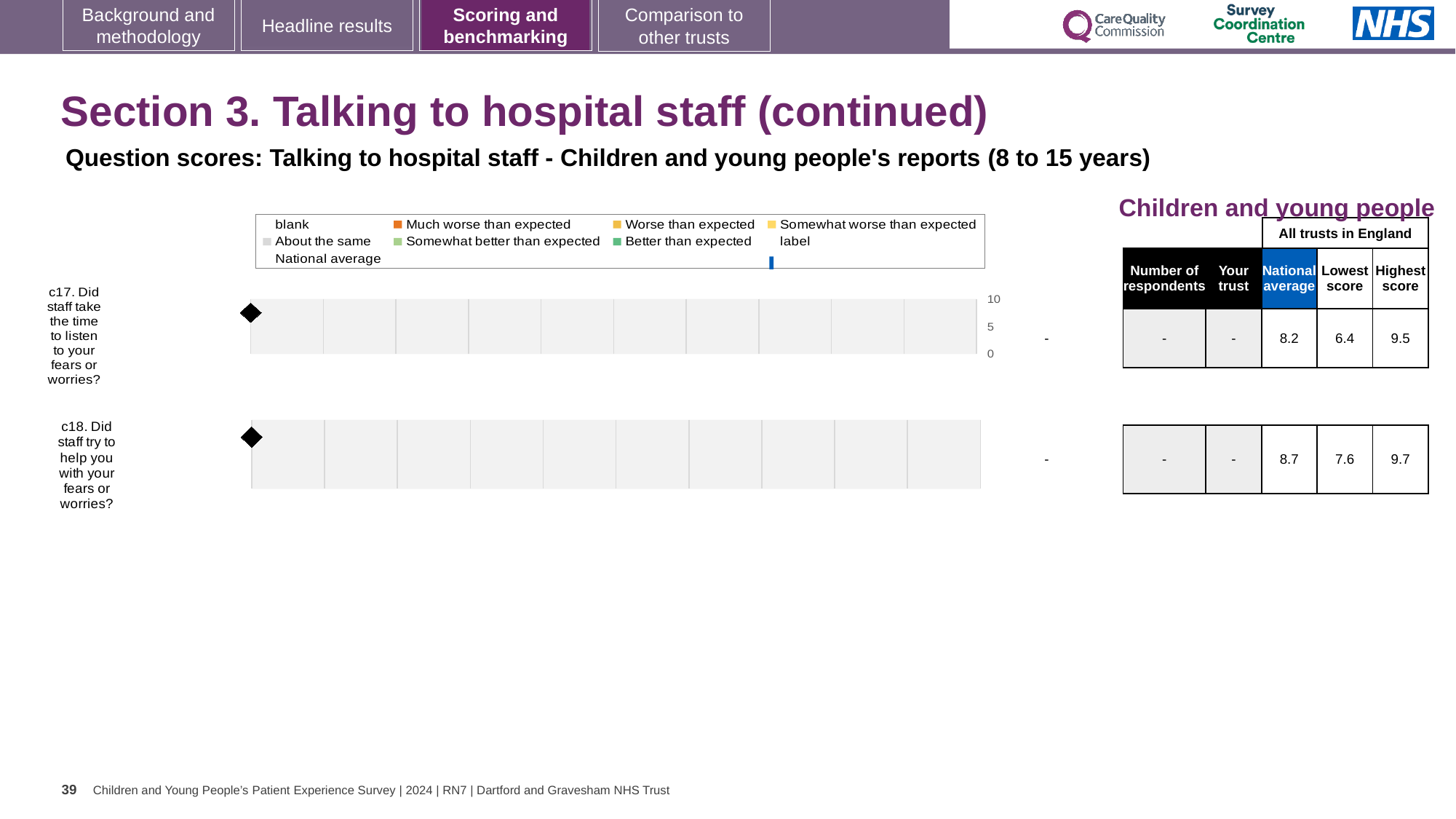
What is the highest score among all trusts in England for c18? 9.7 What kind of chart is used to show the question scores on this slide? bar chart What is the maximum value shown on the chart's score axis? 10 How many questions (categories) are plotted on the chart? 2 Which question has the higher national average, c17 or c18? c18 What is the national average score for c18 (Did staff try to help you with your fears or worries?)? 8.7 What is the lowest score among all trusts in England for c17? 6.4 Which question has the lowest 'Lowest score' value in the table? c17 What is the national average score for c17 (Did staff take the time to listen to your fears or worries?)? 8.2 What is the difference between the highest and lowest scores for c17? 3.1 What is shown as the trust's own score for c17? - What is the difference between the highest and lowest scores for c18? 2.1